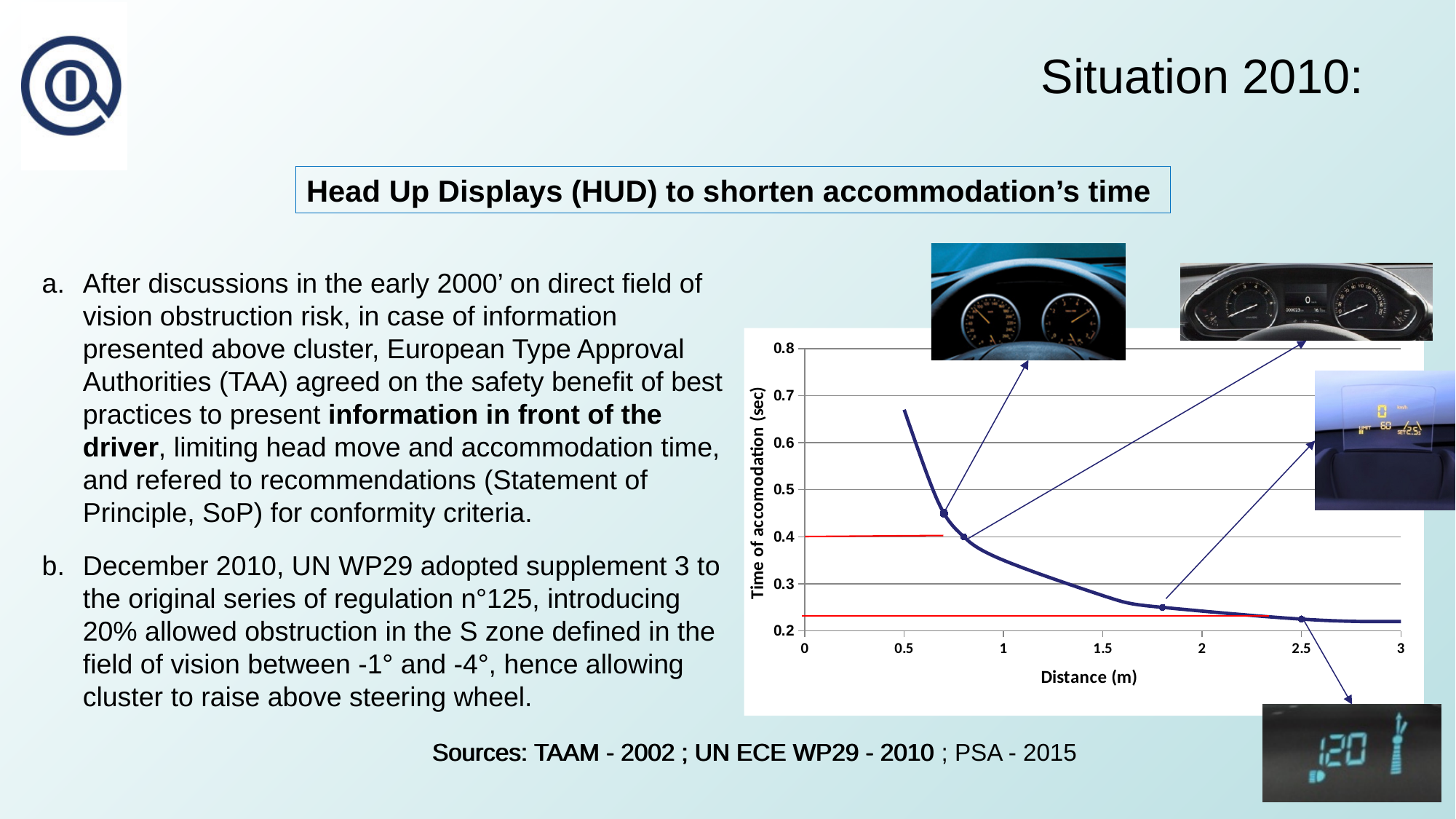
Is the time of accommodation at a distance of 2 m greater or less than 0.3? less Is the time of accommodation at a distance of 0.5 m greater or less than 0.6? greater How many marked data points are shown on the curve? 4 What is the highest value shown on the y axis of the chart? 0.8 Which is larger, the time of accommodation at a distance of 0.5 m or at 2.5 m? 0.5 m Is the time of accommodation at a distance of 1 m greater or less than 0.3? greater What kind of chart is shown on the slide? line chart What is the label of the x axis of the chart? Distance (m) Does the time of accommodation rise or fall as distance increases along the x axis? fall What is the label of the y axis of the chart? Time of accomodation (sec)